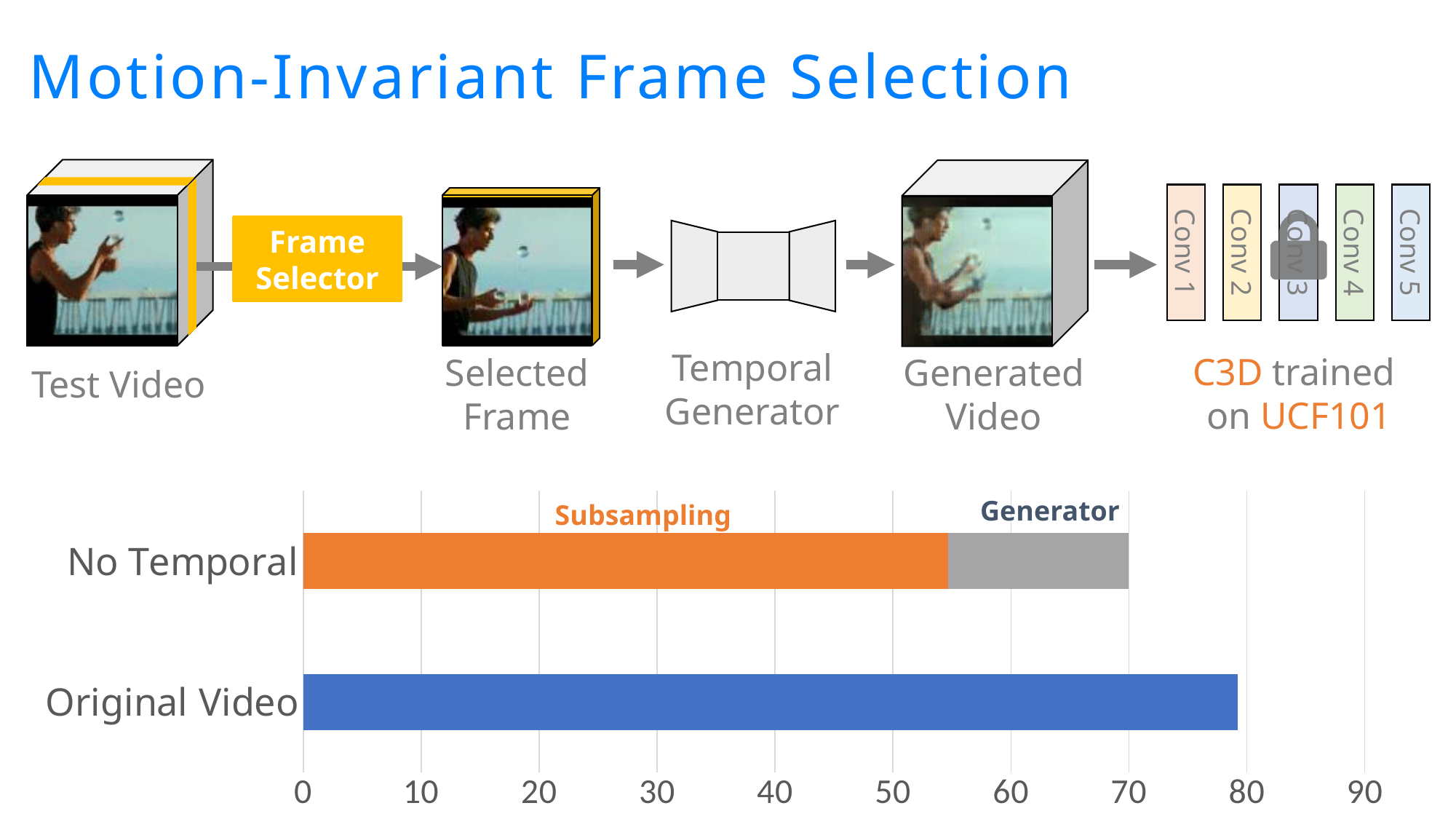
Which category has the shortest total bar in the chart? No Temporal Is the Subsampling portion of the No Temporal bar greater or less than 50? greater How many categories are shown on the vertical axis of the bar chart? 2 Is the Subsampling portion of the No Temporal bar greater or less than 60? less Within the No Temporal bar, which segment is larger, Subsampling or Generator? Subsampling Is the total value of the No Temporal bar greater or less than 60? greater What are the two segment labels shown above the No Temporal bar? Subsampling and Generator Which category has the longer bar, No Temporal or Original Video? Original Video What is the highest tick value shown on the horizontal axis of the chart? 90 What kind of chart is shown at the bottom of the slide? bar chart